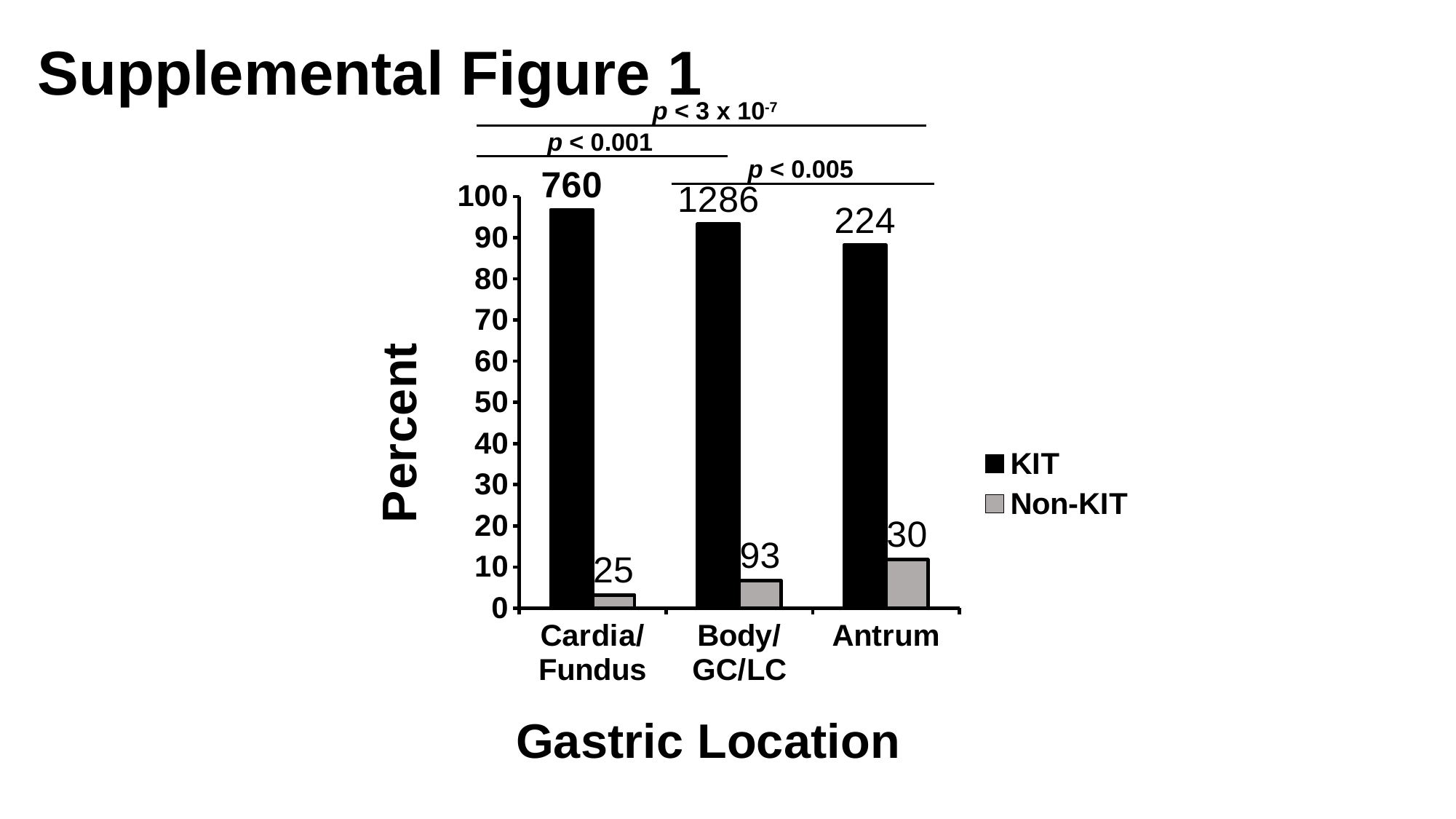
Is the Non-KIT value for Antrum greater or less than 10? greater Which gastric location has the lowest KIT bar? Antrum How many gastric location categories are shown on the x axis? 3 How many series does the legend list? 2 What kind of chart is shown on the slide? bar chart Which gastric location has the highest KIT bar? Cardia/Fundus Which gastric location has the highest Non-KIT bar? Antrum Is the KIT value for Antrum greater or less than 90? less Is the Non-KIT value for Cardia/Fundus greater or less than 10? less Do the KIT bars rise or fall from Cardia/Fundus to Antrum along the x axis? fall What number is printed above the KIT bar for Body/GC/LC? 1286 What is the title of the y axis? Percent